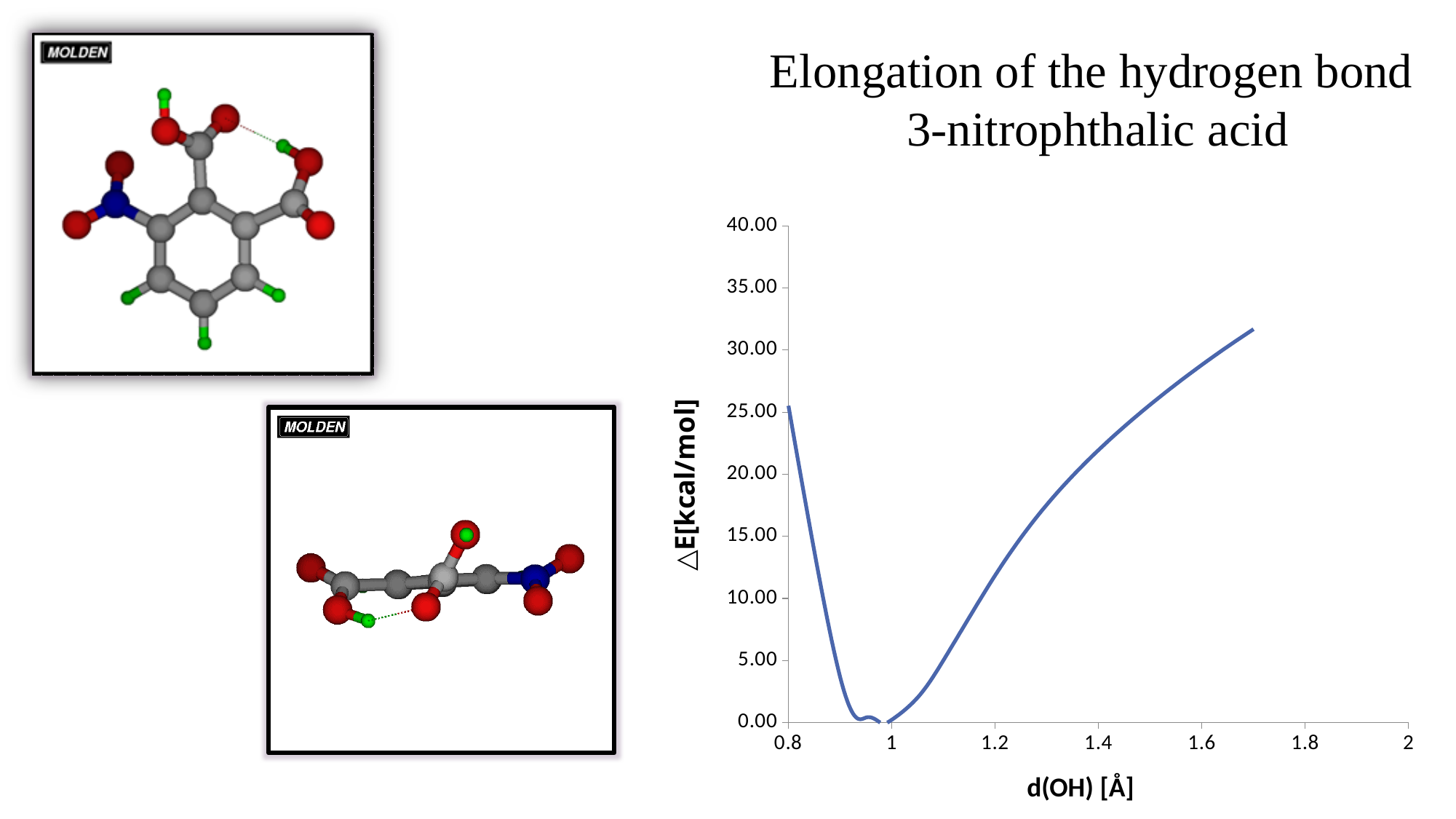
Is the value of △E at d(OH) = 1.4 greater or less than 25.00? less What kind of chart is shown on the slide? line chart How many data series are plotted on the chart? 1 What is the label of the y axis of the chart? △E[kcal/mol] Is the value of △E at d(OH) = 0.8 greater or less than 20.00? greater Is the value of △E at d(OH) = 1.6 greater or less than 25.00? greater Which has the larger △E value: d(OH) = 0.8 or d(OH) = 1.7? d(OH) = 1.7 Does △E rise or fall as d(OH) increases from 1.0 to 1.6? rise What is the label of the x axis of the chart? d(OH) [Å] Does △E rise or fall as d(OH) increases from 0.8 to 0.95? fall